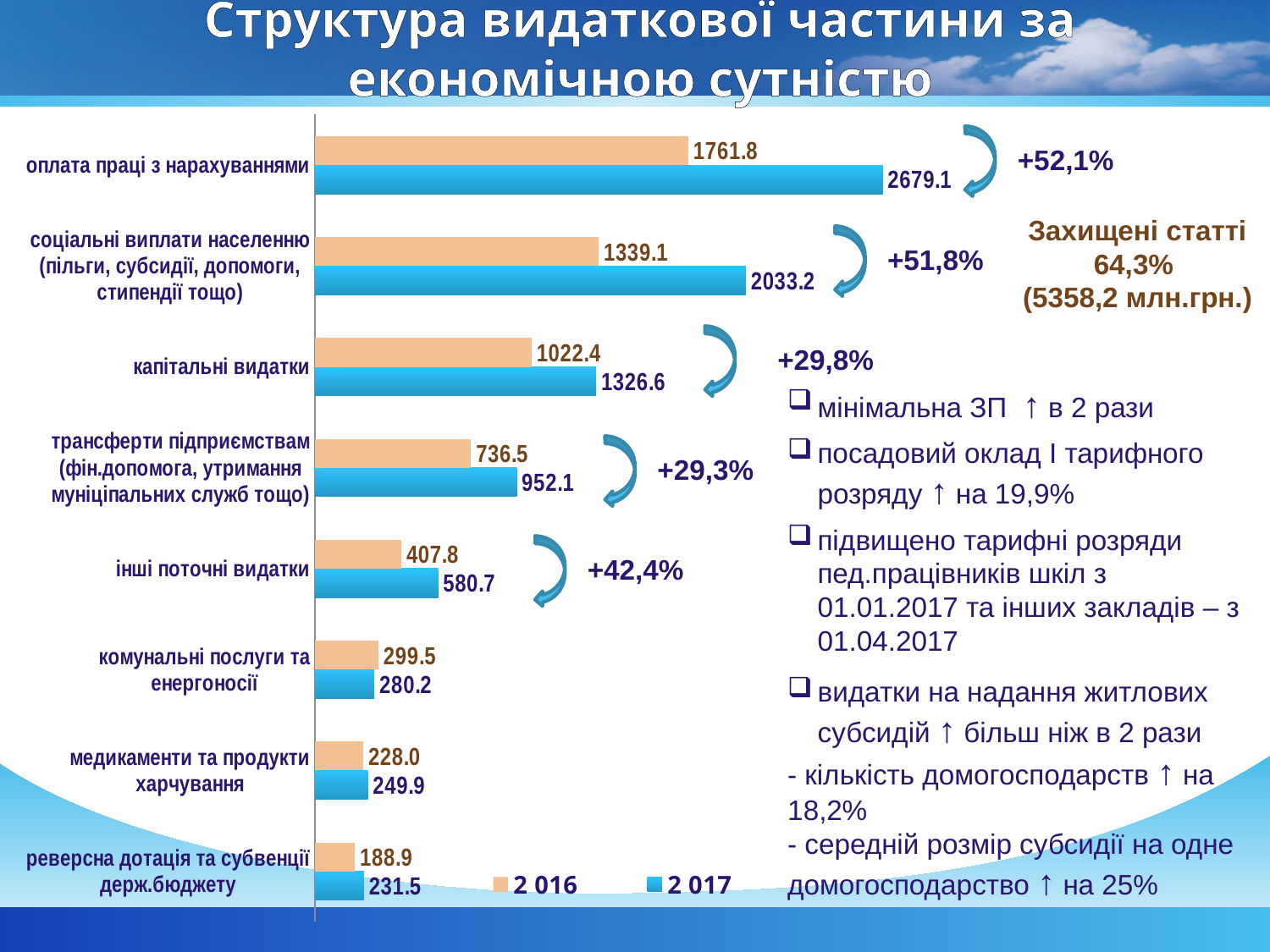
How many series does the legend list? 2 How many categories are shown in the chart? 8 Which category has the highest 2017 value? оплата праці з нарахуваннями What is the difference between the 2017 and 2016 values for оплата праці з нарахуваннями? 917.3 What kind of chart is shown on the slide? bar chart What is the 2016 value for капітальні видатки? 1022.4 What is the 2016 value for реверсна дотація та субвенції держ.бюджету? 188.9 What is the difference between the 2016 and 2017 values for комунальні послуги та енергоносії? 19.3 What is the 2017 value for інші поточні видатки? 580.7 What is the 2017 value for оплата праці з нарахуваннями? 2679.1 For комунальні послуги та енергоносії, which year has the larger value, 2016 or 2017? 2016 Which category has the lowest 2016 value? реверсна дотація та субвенції держ.бюджету